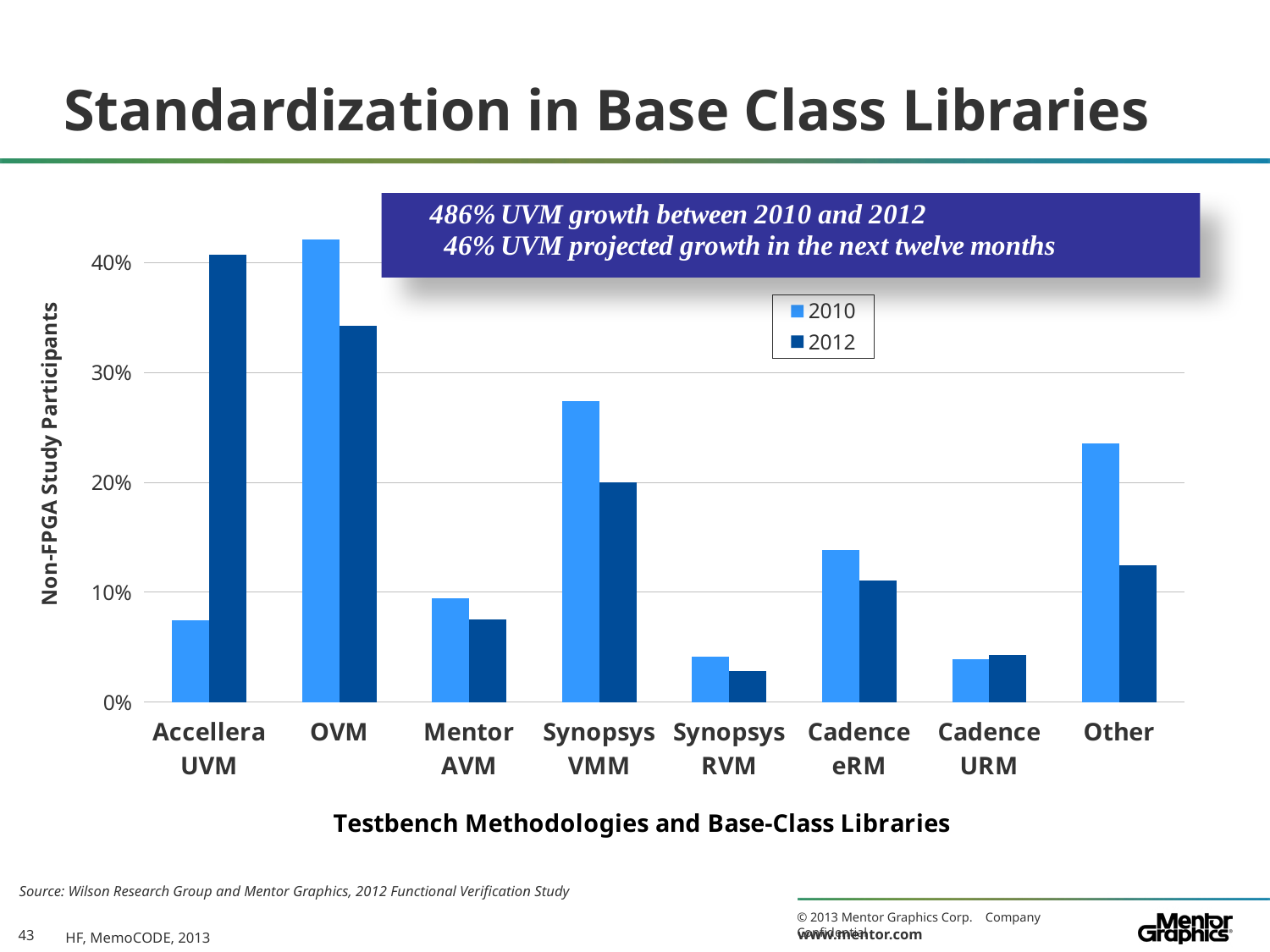
For Other, which series has the larger value, 2010 or 2012? 2010 For Accellera UVM, which series has the larger value, 2010 or 2012? 2012 Is the 2010 value for OVM greater or less than 40%? greater Which category has the highest value for the 2010 series? OVM How many categories are shown on the x axis? 8 How many series does the legend list? 2 What kind of chart is shown on the slide? bar chart What is the label of the y axis? Non-FPGA Study Participants Which category has the highest value for the 2012 series? Accellera UVM Is the 2010 value for Synopsys VMM greater or less than 20%? greater Is the 2010 value for Cadence eRM greater or less than 10%? greater